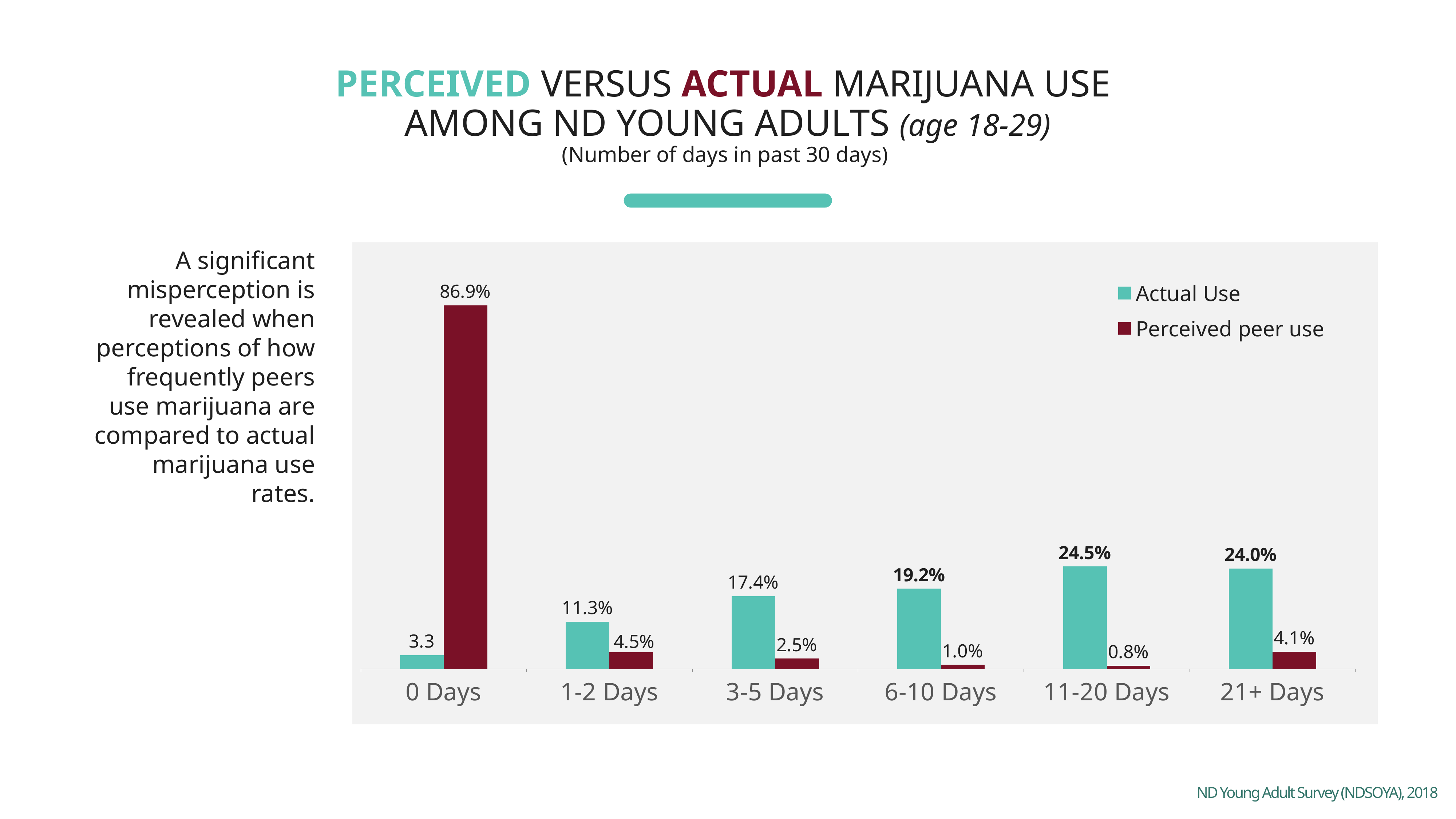
Which category has the lowest Actual Use value? 0 Days What is the difference between Actual Use and Perceived peer use for 21+ Days? 19.9% How many series does the legend list? 2 How many day-range categories are shown on the x axis? 6 Which category has the highest Perceived peer use value? 0 Days What is the Actual Use value for 3-5 Days? 17.4% Which category has the lowest Perceived peer use value? 11-20 Days What kind of chart is shown on the slide? Bar chart What is the Actual Use value for 11-20 Days? 24.5% What is the Perceived peer use value for 0 Days? 86.9% For 1-2 Days, which is larger: Actual Use or Perceived peer use? Actual Use What is the Perceived peer use value for 6-10 Days? 1.0%